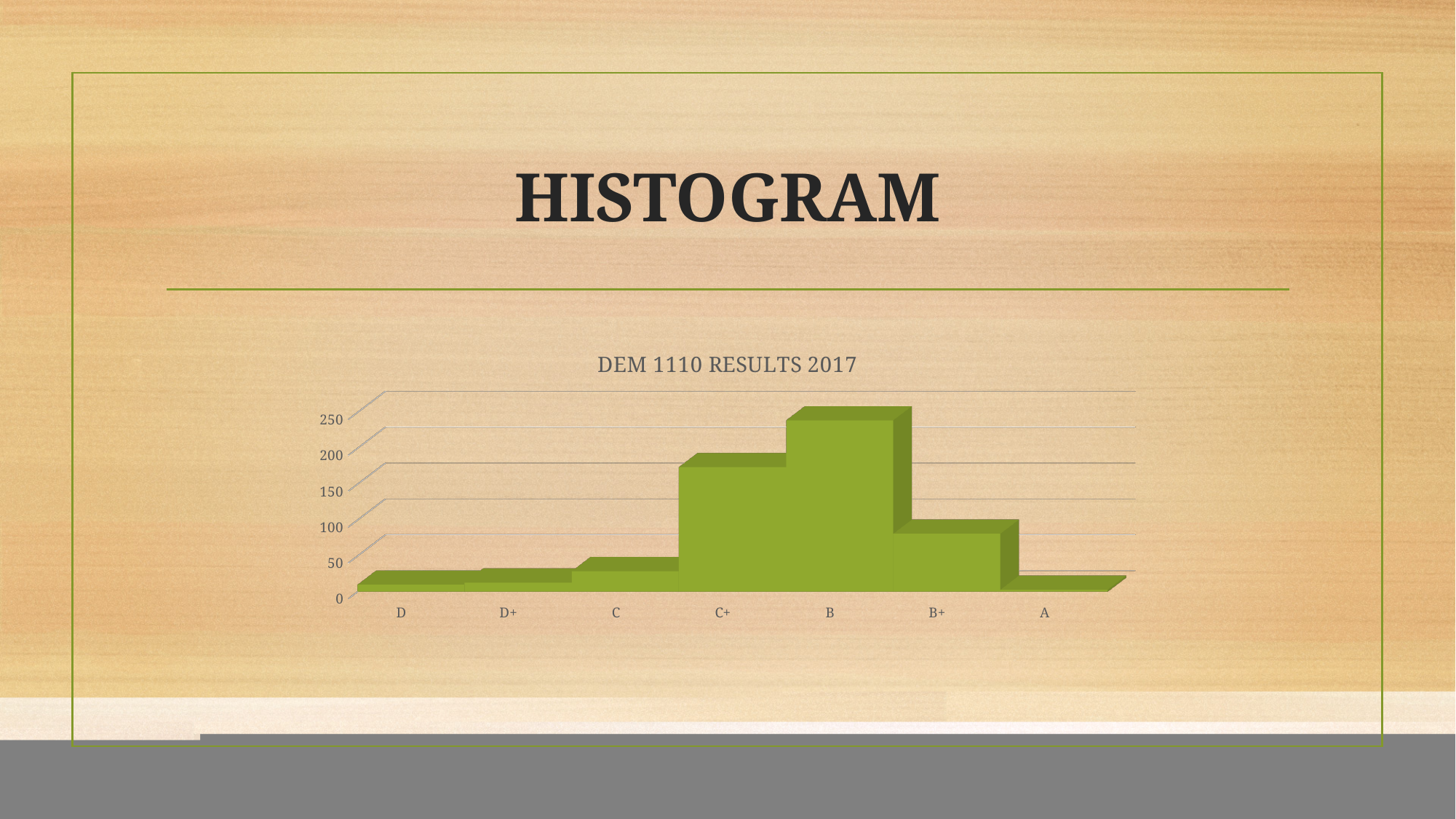
Is the value for C+ greater or less than 150? greater Which is larger, the value for C+ or the value for B+? C+ Is the value for A greater or less than 50? less Do the values rise or fall from D to B along the x axis? rise Which is larger, the value for D+ or the value for C? C Is the value for B greater or less than 200? greater Which grade category has the highest value? B How many grade categories are shown on the x axis? 7 What is the title of the chart? DEM 1110 RESULTS 2017 What kind of chart is shown on the slide? bar chart